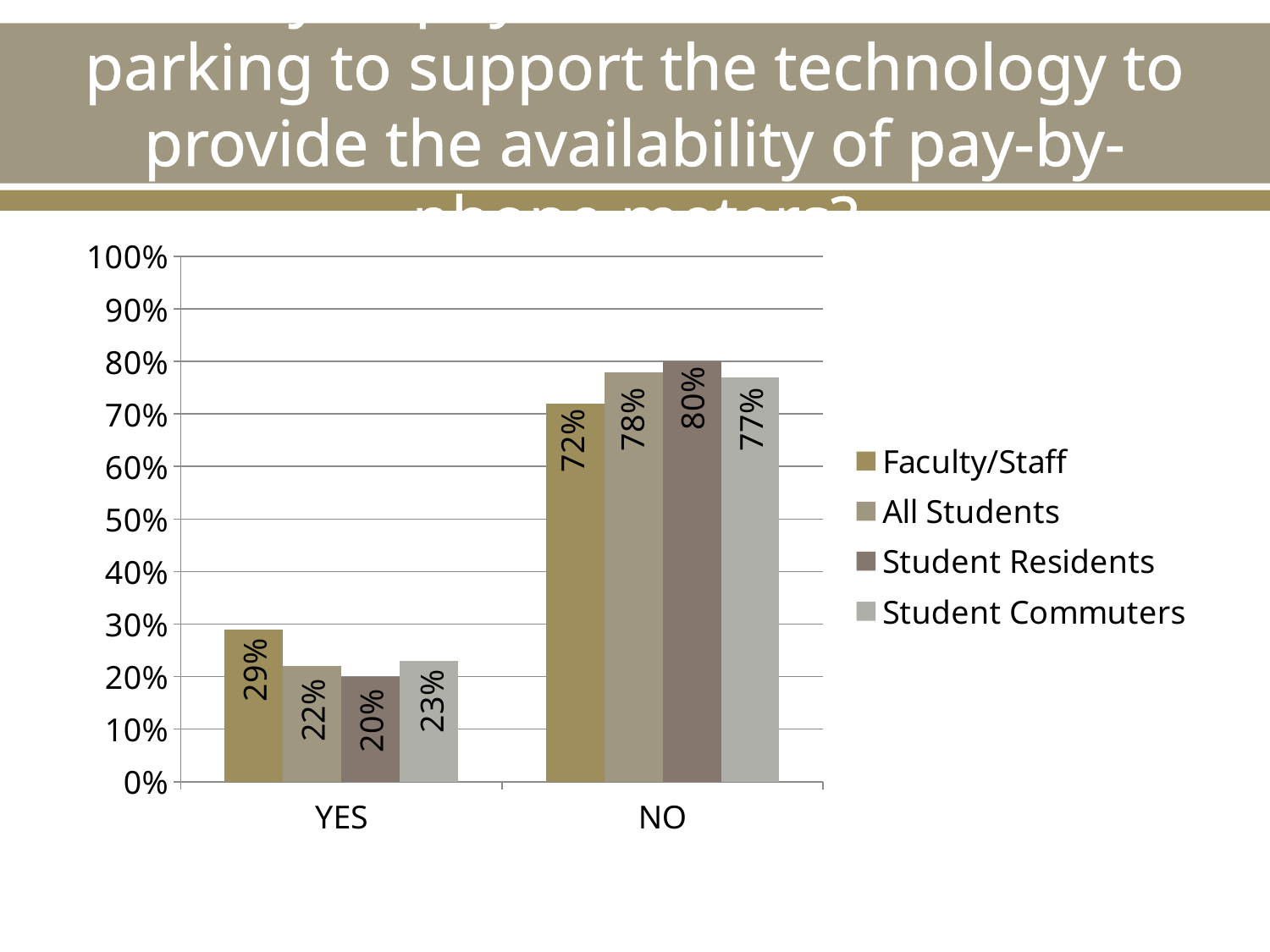
What percentage of Student Commuters answered NO? 77% What kind of chart is shown on the slide? Bar chart Which is larger: the YES percentage for Faculty/Staff or the YES percentage for Student Commuters? Faculty/Staff What percentage of Faculty/Staff answered YES? 29% What percentage of All Students answered YES? 22% What is the difference between the Faculty/Staff NO percentage and the Faculty/Staff YES percentage? 43% Which group has the highest percentage answering NO? Student Residents Which group has the lowest percentage answering YES? Student Residents What percentage of Student Residents answered NO? 80% What is the difference between the All Students NO percentage and the Student Commuters NO percentage? 1% How many categories are shown on the x axis? 2 How many series does the legend list? 4